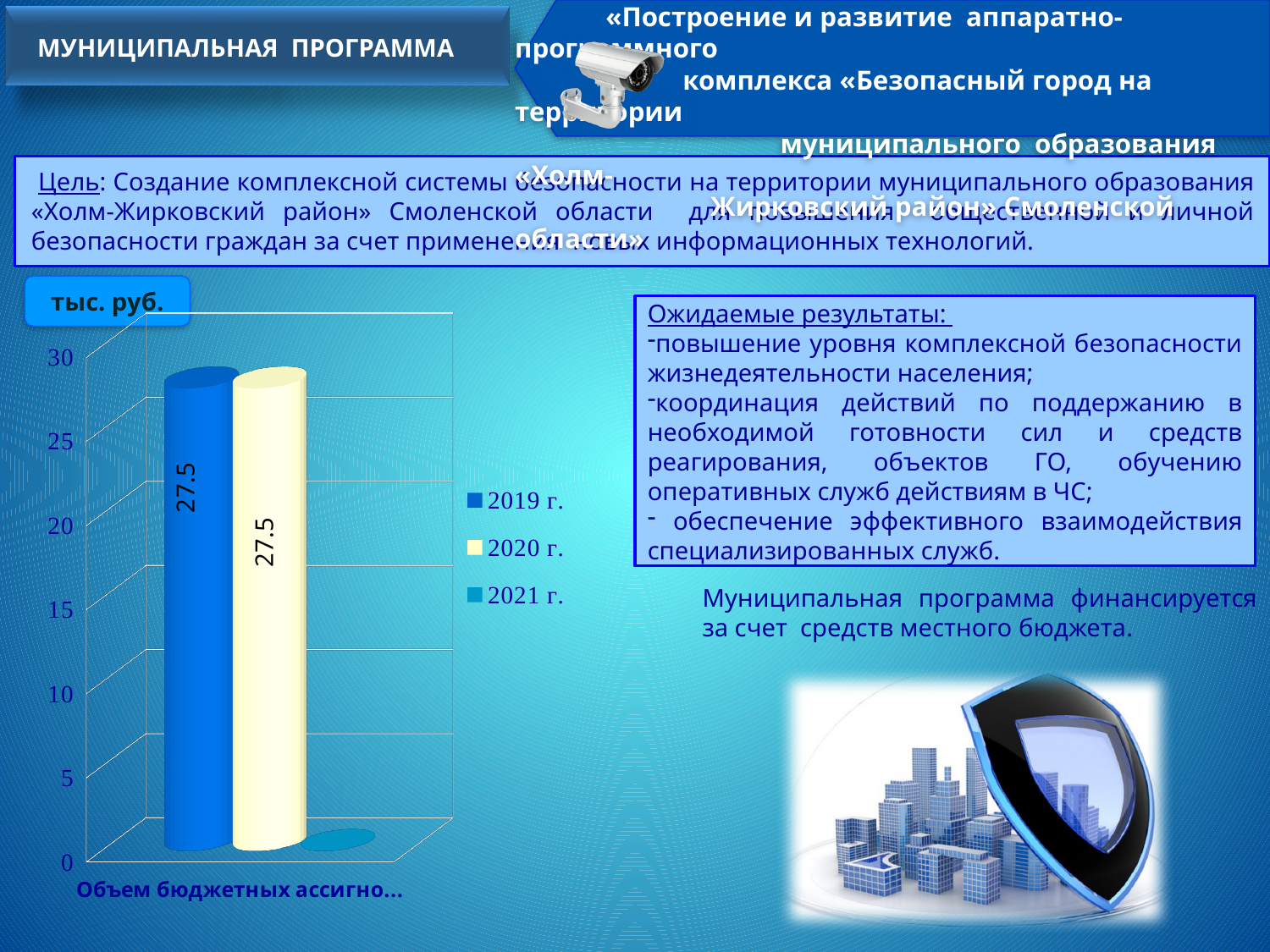
Is the value for 2020 г. larger than, smaller than, or equal to the value for 2019 г.? equal Is the value for 2019 г. greater or less than 25? greater What kind of chart is shown on the slide? bar chart What unit is indicated for the chart values? тыс. руб. What is the value for 2020 г. in the chart? 27.5 What colour is the bar for 2019 г. in the chart? blue Which series has the lowest value in the chart? 2021 г. Is the value for 2021 г. greater or less than 5? less What is the value for 2019 г. in the chart? 27.5 What is the difference between the values for 2019 г. and 2020 г.? 0 How many series does the chart legend list? 3